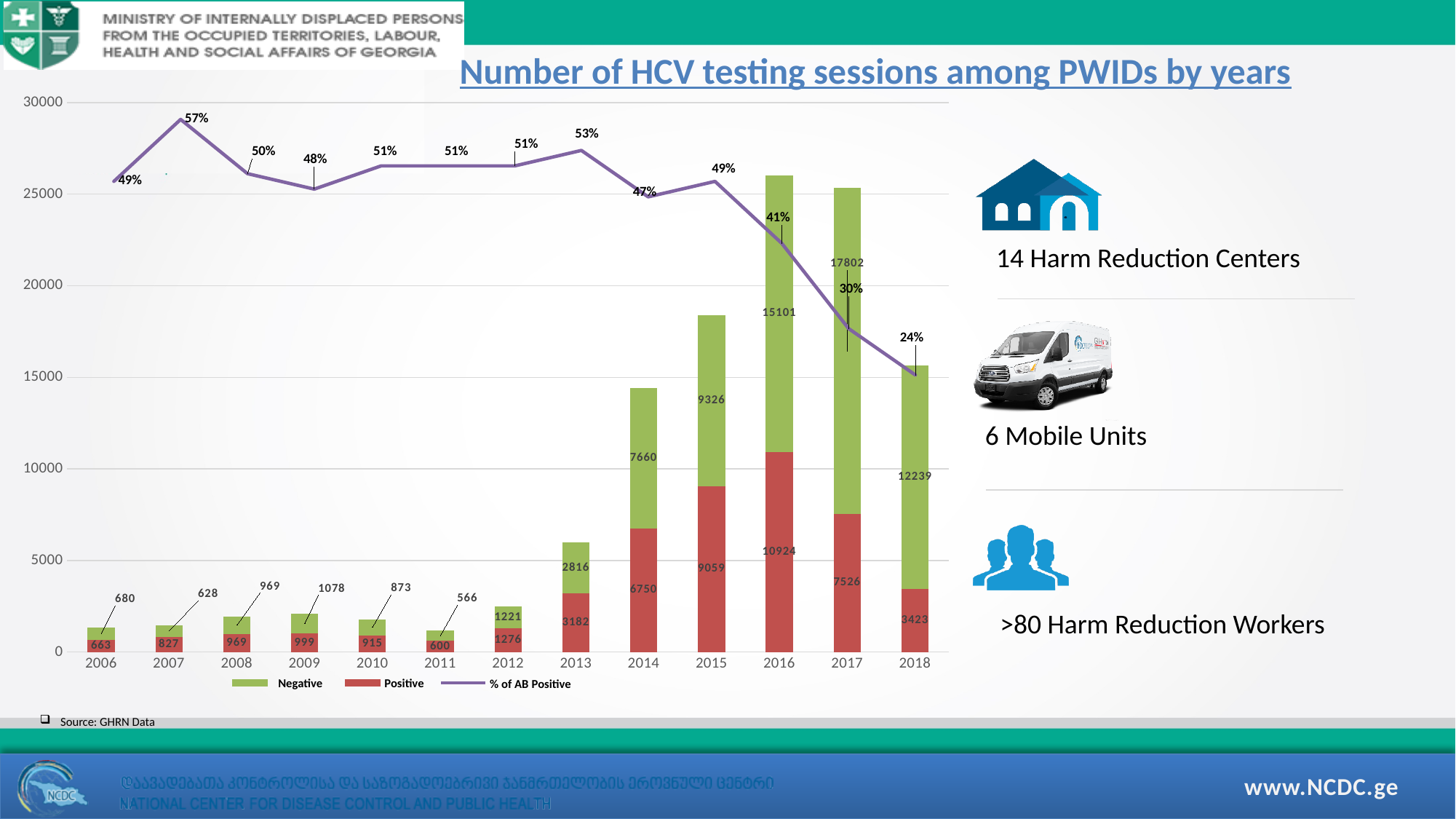
Which year has the highest % of AB Positive? 2007 Which year has the highest Positive value? 2016 What is the Negative value for 2017? 17802 What is the total of the stacked bar for 2016 (Positive plus Negative)? 26025 Which year has the lowest % of AB Positive? 2018 Does the % of AB Positive rise or fall from 2015 to 2018? Fall How many series does the legend list? 3 What is the difference between the Negative value for 2017 and the Negative value for 2016? 2701 What is the Positive value for 2016? 10924 What kind of chart is shown on the slide? Stacked bar chart with a line What is the % of AB Positive for 2007? 57% How many years are shown on the x axis? 13